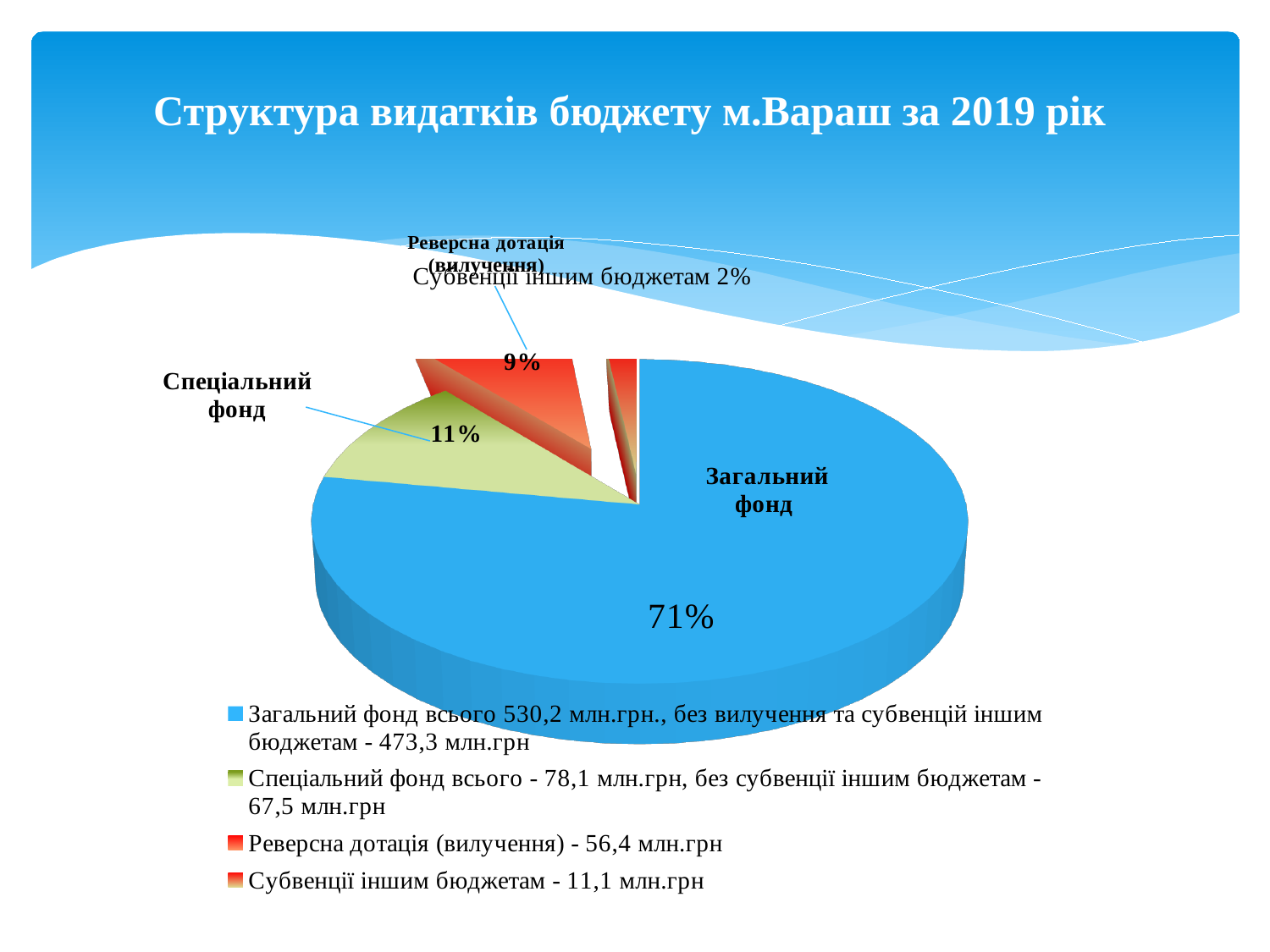
What is the title of the chart? Структура видатків бюджету м.Вараш за 2019 рік How many entries does the legend list? 4 Which slice of the pie is the largest? Загальний фонд What kind of chart is shown on the slide? pie chart What share of the pie does Реверсна дотація (вилучення) take? 9% What share of the pie does Субвенції іншим бюджетам take? 2% Which slice of the pie is the smallest? Субвенції іншим бюджетам What share of the pie does Спеціальний фонд take? 11% What is the difference in percentage points between the Загальний фонд share and the Спеціальний фонд share? 60 How many slices does the pie chart have? 4 Which is larger, the share for Спеціальний фонд or the share for Реверсна дотація (вилучення)? Спеціальний фонд